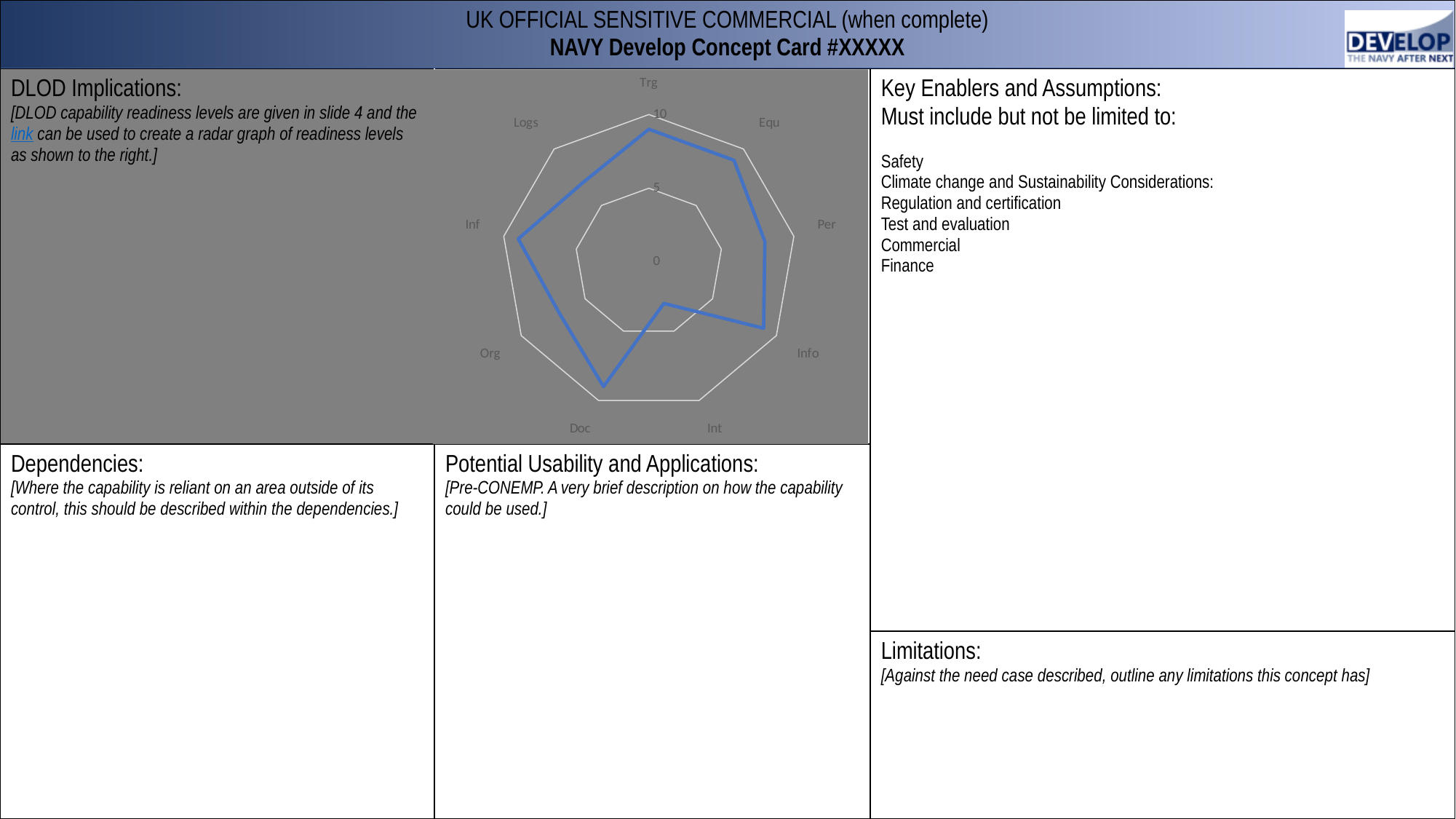
How many categories (axes) does the radar chart have? 9 Is the value for Doc greater or less than 5? greater Is the value for Trg greater or less than 5? greater Which category has the lowest value on the radar chart? Int Is the value for Info greater or less than 5? greater Which is larger, the value for Info or the value for Int? Info What kind of chart is shown on the slide? radar chart What is the highest tick value shown on the radar chart's scale? 10 What colour is the plotted data line on the radar chart? blue